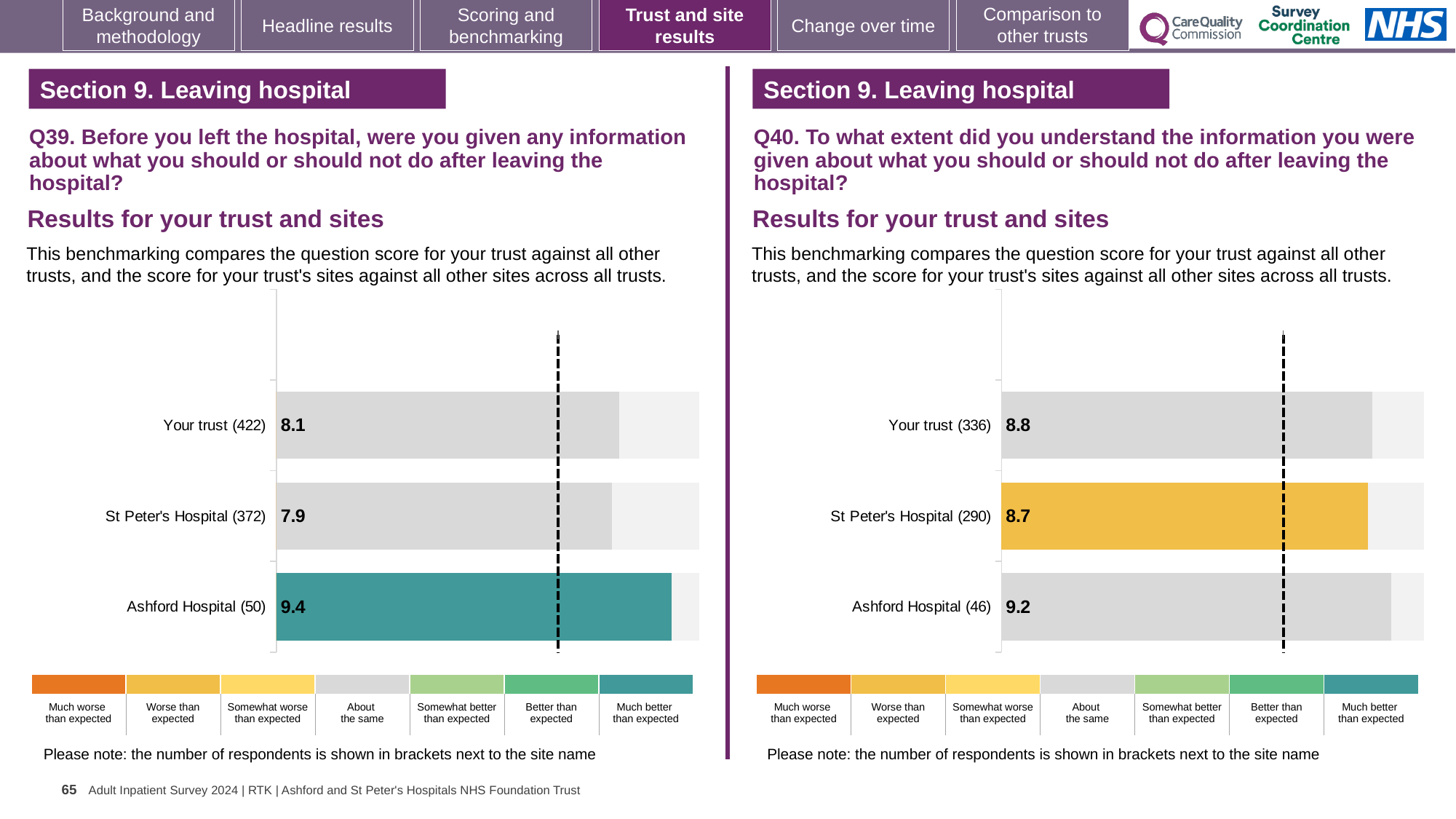
In the Q39 chart on the left, what is the score for Ashford Hospital? 9.4 In the Q39 chart on the left, how many respondents are shown for Your trust? 422 What kind of chart is used in the Q39 chart on the left? Bar chart In the Q39 chart on the left, which site or trust has the highest score? Ashford Hospital In the Q39 chart on the left, what is the difference between the scores for Ashford Hospital and St Peter's Hospital? 1.5 In the Q39 chart on the left, which site or trust has the lowest score? St Peter's Hospital In the Q40 chart on the right, what is the score for Ashford Hospital? 9.2 In the Q40 chart on the right, what is the score for St Peter's Hospital? 8.7 In the Q40 chart on the right, how many bars are plotted? 3 In the Q39 chart on the left, what is the score for Your trust? 8.1 In the Q40 chart on the right, what is the difference between the scores for Your trust and St Peter's Hospital? 0.1 In the Q40 chart on the right, which site or trust has the highest score? Ashford Hospital